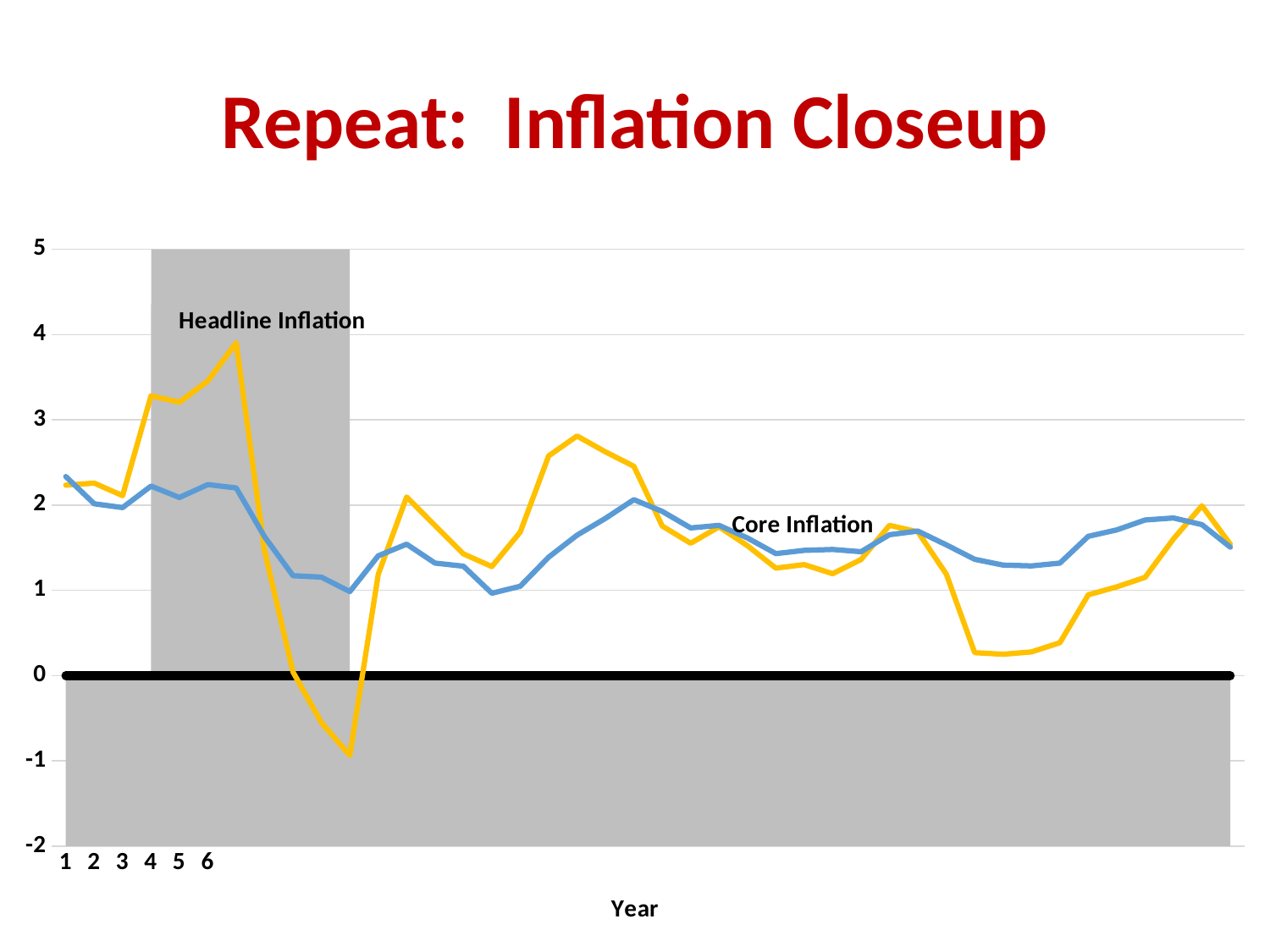
What type of chart is shown on the slide? Line chart Is the lowest value of Headline Inflation greater or less than 0? less How many data series are plotted on the chart? 2 Which series reaches the lowest value on the chart? Headline Inflation Is the highest value of Core Inflation greater or less than 3? less What is the title of the x axis? Year Which series reaches the highest value on the chart? Headline Inflation Does the Core Inflation line ever drop below zero? No Is Core Inflation at the end of the series higher or lower than at year 1? Lower What colour is the Headline Inflation line? Yellow Is the lowest value of Core Inflation greater or less than 0? greater